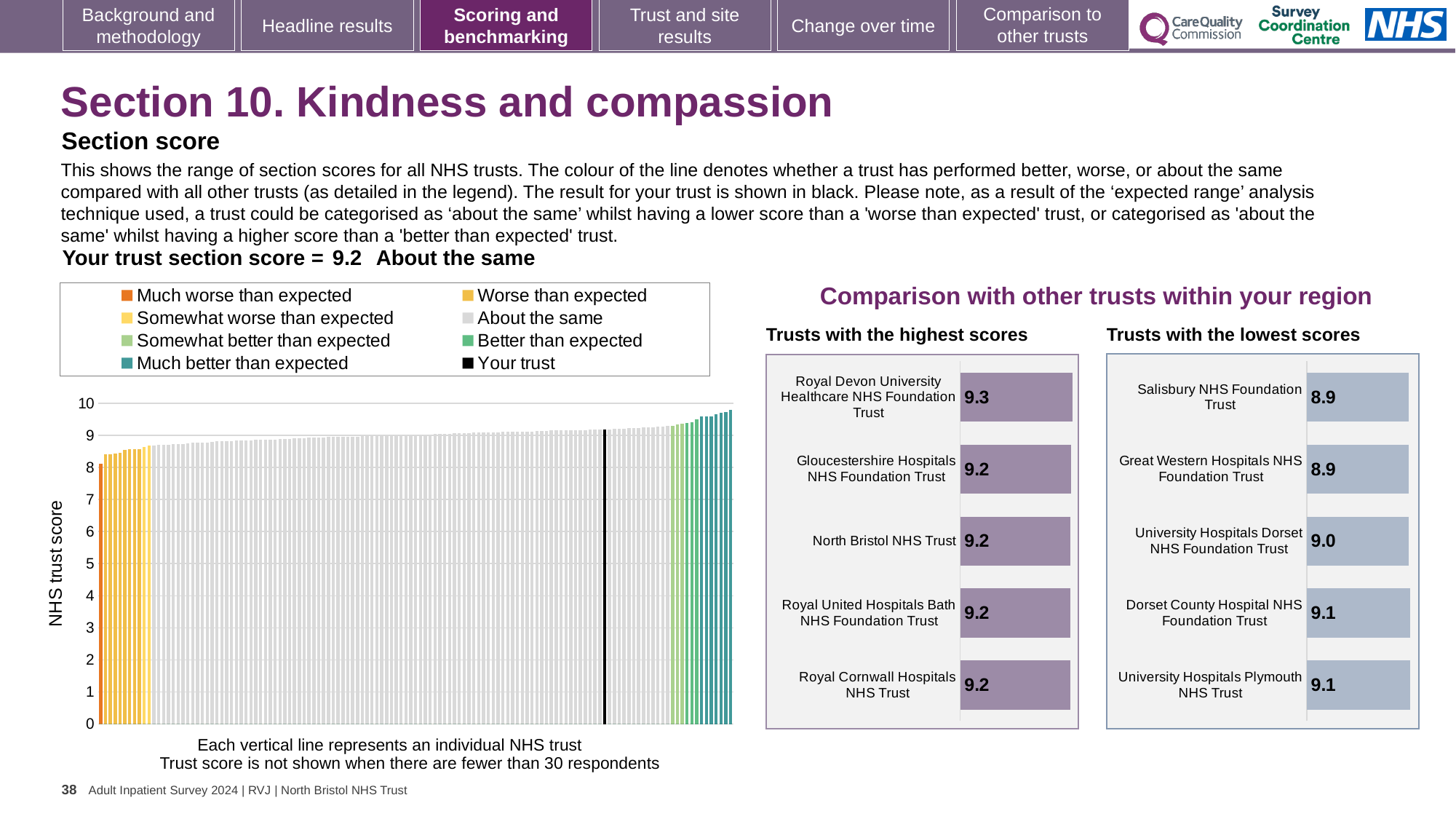
In the large chart on the left, how many entries does the legend list? 8 In the 'Trusts with the highest scores' chart, what is the difference between the scores of Royal Devon University Healthcare NHS Foundation Trust and North Bristol NHS Trust? 0.1 In the 'Trusts with the lowest scores' chart, what is the difference between the scores of University Hospitals Plymouth NHS Trust and Great Western Hospitals NHS Foundation Trust? 0.2 In the large chart on the left, is the value of the black bar (your trust) greater or less than 9? greater In the 'Trusts with the highest scores' chart, how many trusts are shown? 5 In the 'Trusts with the lowest scores' chart, what is the score for University Hospitals Dorset NHS Foundation Trust? 9.0 In the 'Trusts with the lowest scores' chart, which has the larger score: Dorset County Hospital NHS Foundation Trust or Salisbury NHS Foundation Trust? Dorset County Hospital NHS Foundation Trust In the large chart on the left, what is the label on the vertical axis? NHS trust score What kind of chart is the large chart on the left of the slide showing NHS trust scores? bar chart In the large chart on the left, do the trust scores rise or fall from left to right along the x axis? rise In the 'Trusts with the highest scores' chart, what is the score for Royal Devon University Healthcare NHS Foundation Trust? 9.3 In the 'Trusts with the highest scores' chart, which trust has the highest score? Royal Devon University Healthcare NHS Foundation Trust